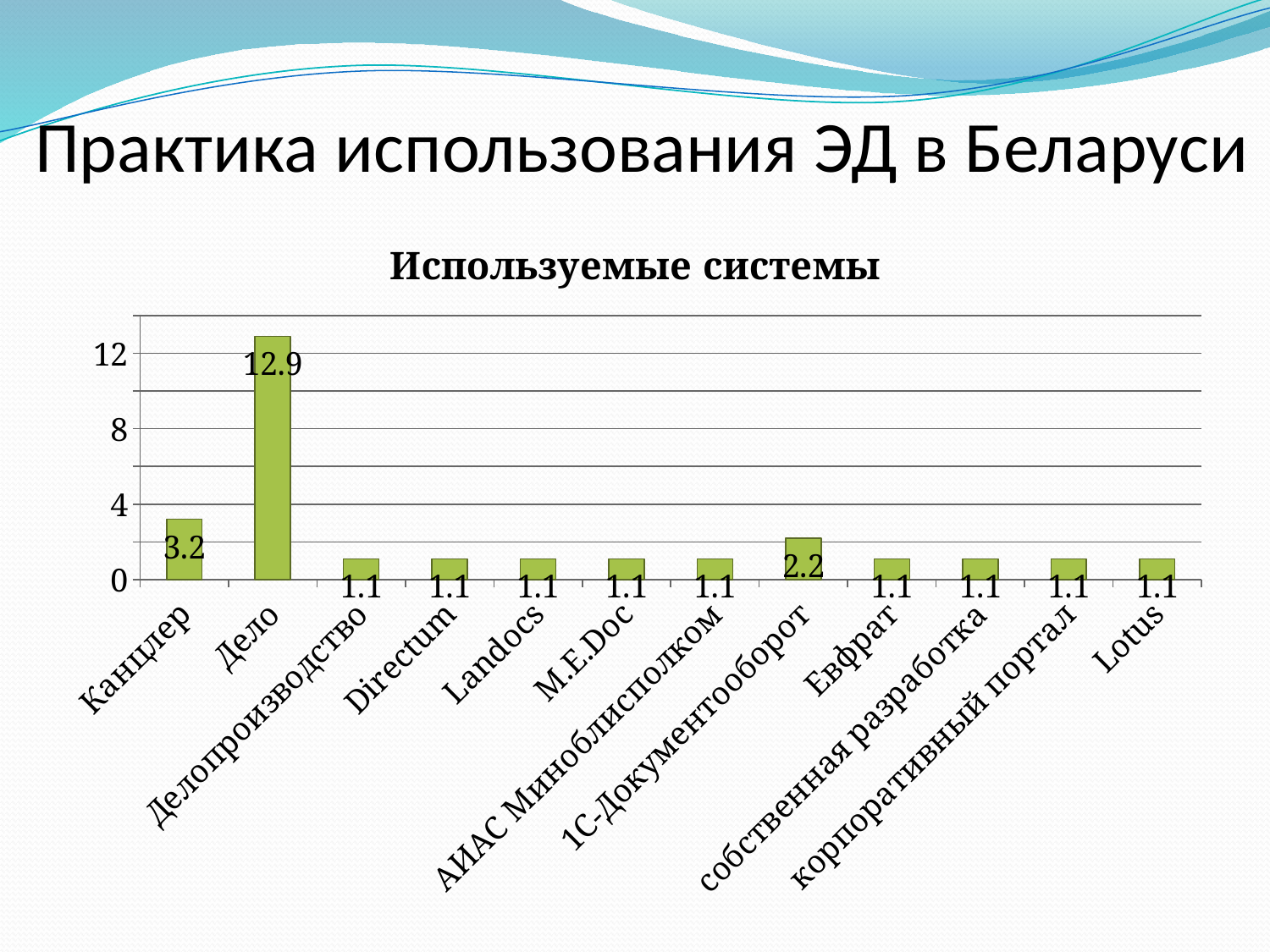
How many categories are shown on the x axis? 12 What is the difference between the values for Дело and Канцлер? 9.7 What is the difference between the values for Канцлер and 1С-Документооборот? 1.0 What is the value for Дело? 12.9 Is the value for Дело greater or less than 12? greater Which is larger, the value for Канцлер or the value for 1С-Документооборот? Канцлер What is the value for Канцлер? 3.2 What is the title of the chart? Используемые системы What kind of chart is shown? bar chart What is the value for 1С-Документооборот? 2.2 What is the value for Directum? 1.1 Which category has the highest value? Дело